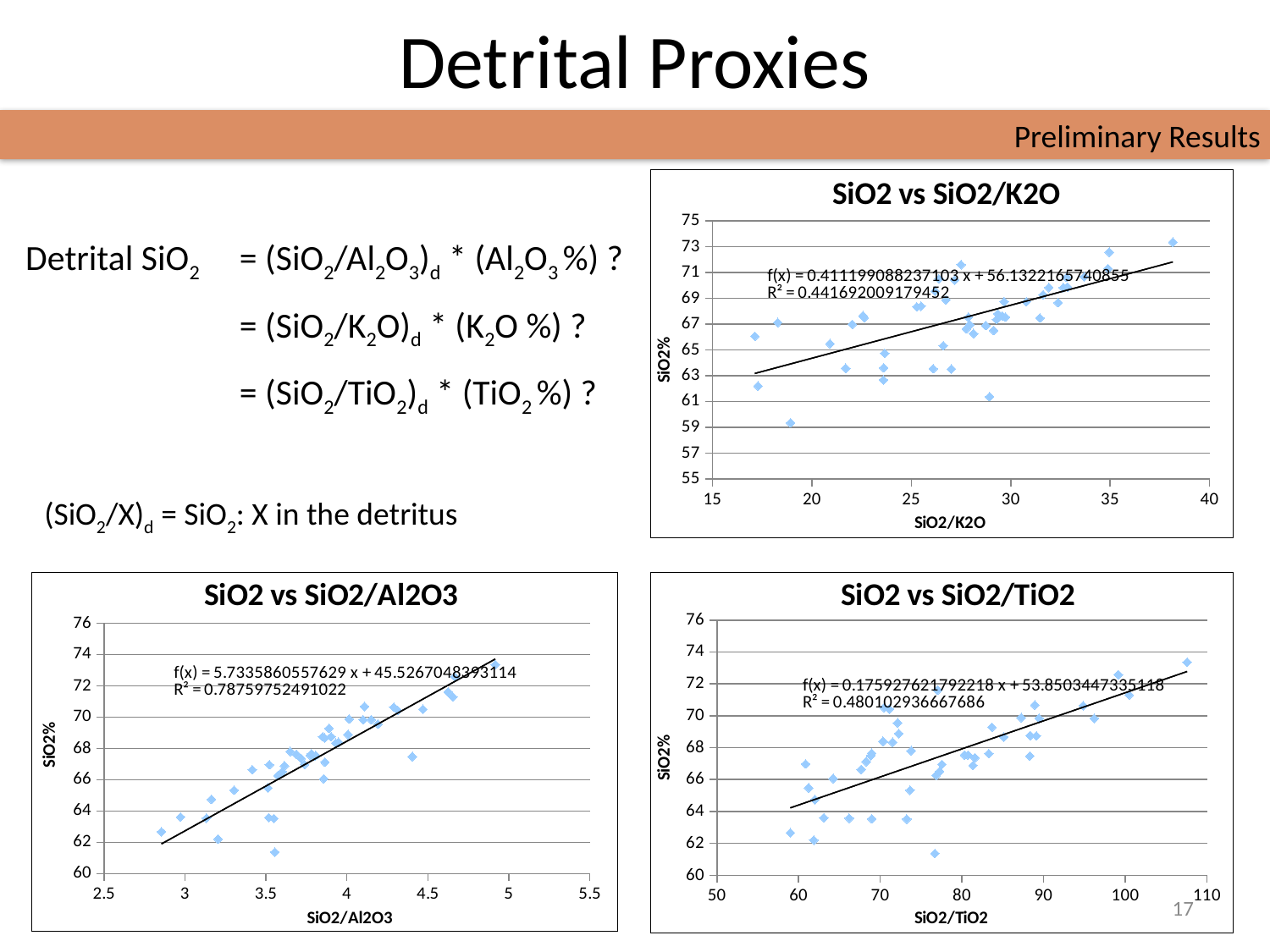
How many charts are shown on the slide? 3 In the "SiO2 vs SiO2/TiO2" chart, do the SiO2% values generally rise or fall as SiO2/TiO2 increases? rise What R² value is printed on the "SiO2 vs SiO2/TiO2" chart? 0.480102936667686 In the "SiO2 vs SiO2/K2O" chart, is the highest plotted SiO2% value greater or less than 71? greater What kind of chart is "SiO2 vs SiO2/K2O"? scatter chart Which of the three charts on the slide shows the highest R² value? SiO2 vs SiO2/Al2O3 In the "SiO2 vs SiO2/K2O" chart, is the lowest plotted SiO2% value greater or less than 61? less What is the x-axis title of the "SiO2 vs SiO2/TiO2" chart? SiO2/TiO2 What R² value is printed on the "SiO2 vs SiO2/Al2O3" chart? 0.78759752491022 In the "SiO2 vs SiO2/Al2O3" chart, do the SiO2% values generally rise or fall as SiO2/Al2O3 increases? rise What is the slope of the trendline equation printed on the "SiO2 vs SiO2/Al2O3" chart? 5.7335860557629 What R² value is printed on the "SiO2 vs SiO2/K2O" chart? 0.441692009179452